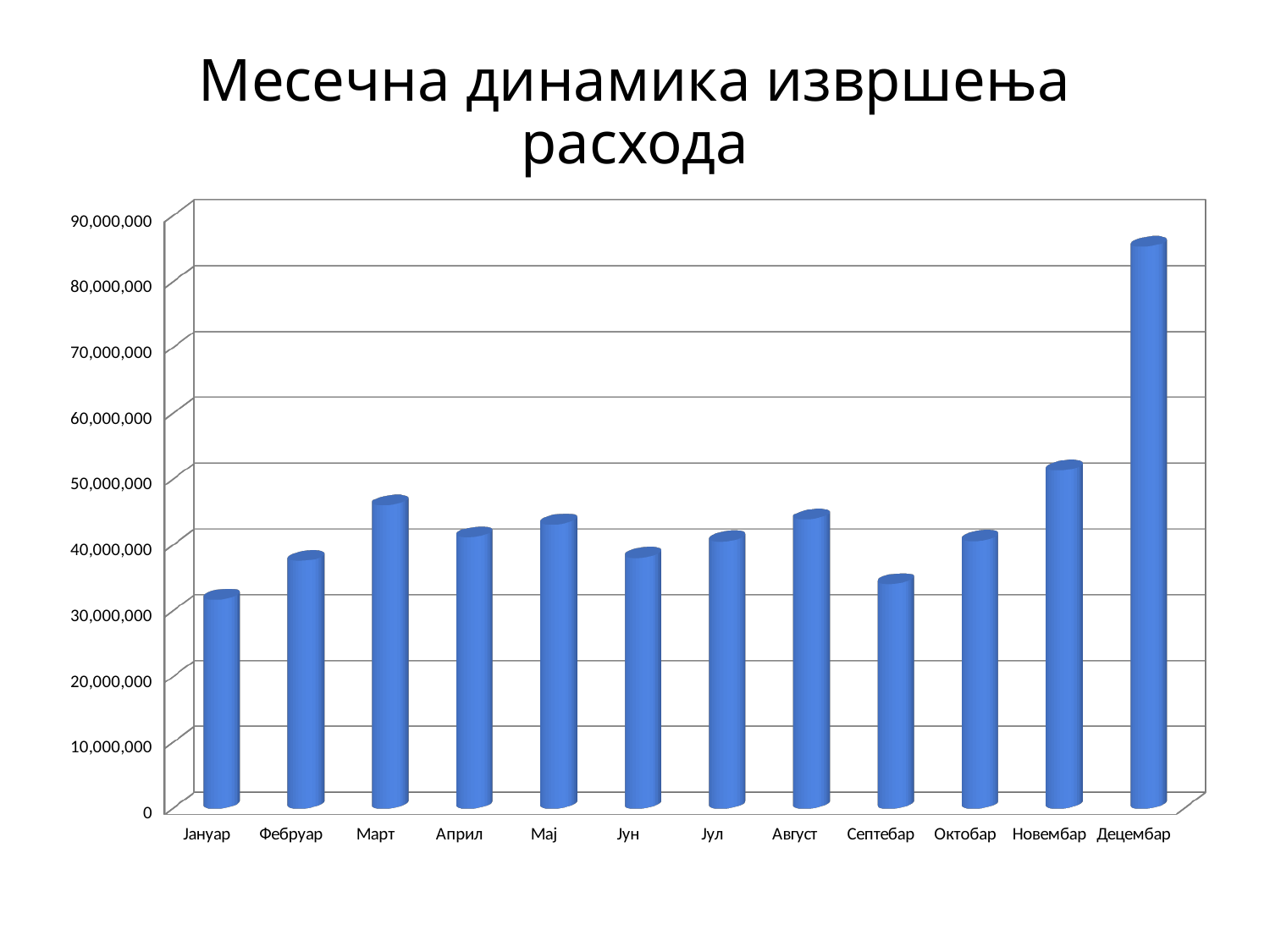
Is the value for Септебар greater or less than 40,000,000? less Is the value for Новембар greater or less than 60,000,000? less Is the value for Децембар greater or less than 80,000,000? greater Which month has the lowest value? Јануар What kind of chart is shown on the slide? bar chart Do the values rise or fall from Септебар to Децембар? rise Which month has the highest value? Децембар Which is larger, the value for Март or the value for Април? Март What is the title of the chart? Месечна динамика извршења расхода How many months (categories) are shown on the x axis? 12